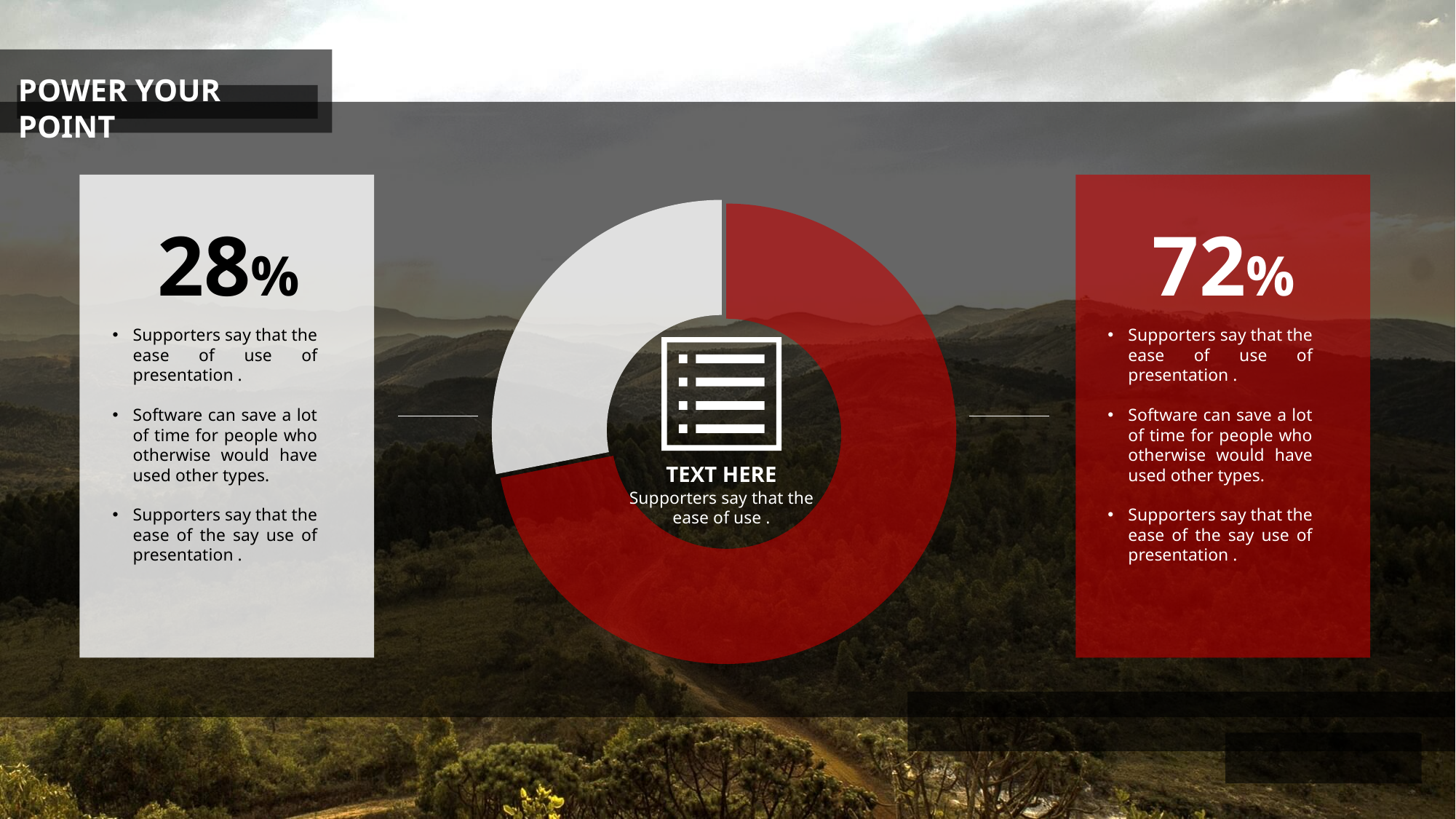
Which slice of the donut chart is the smallest? The light grey slice How many slices does the donut chart have? 2 Is the red slice of the donut chart greater or less than 50%? greater What percentage does the light grey slice of the donut chart represent? 28% What is the difference in percentage points between the red slice and the light grey slice? 44 What percentage does the red slice of the donut chart represent? 72% What kind of chart is shown in the centre of the slide? Donut chart What text label appears in the centre of the donut chart? TEXT HERE Which slice of the donut chart is the largest? The red slice Is the red slice or the light grey slice of the donut chart larger? The red slice What do the two slices of the donut chart add up to? 100% What colour is the panel on the right side of the slide that shows 72%? Red